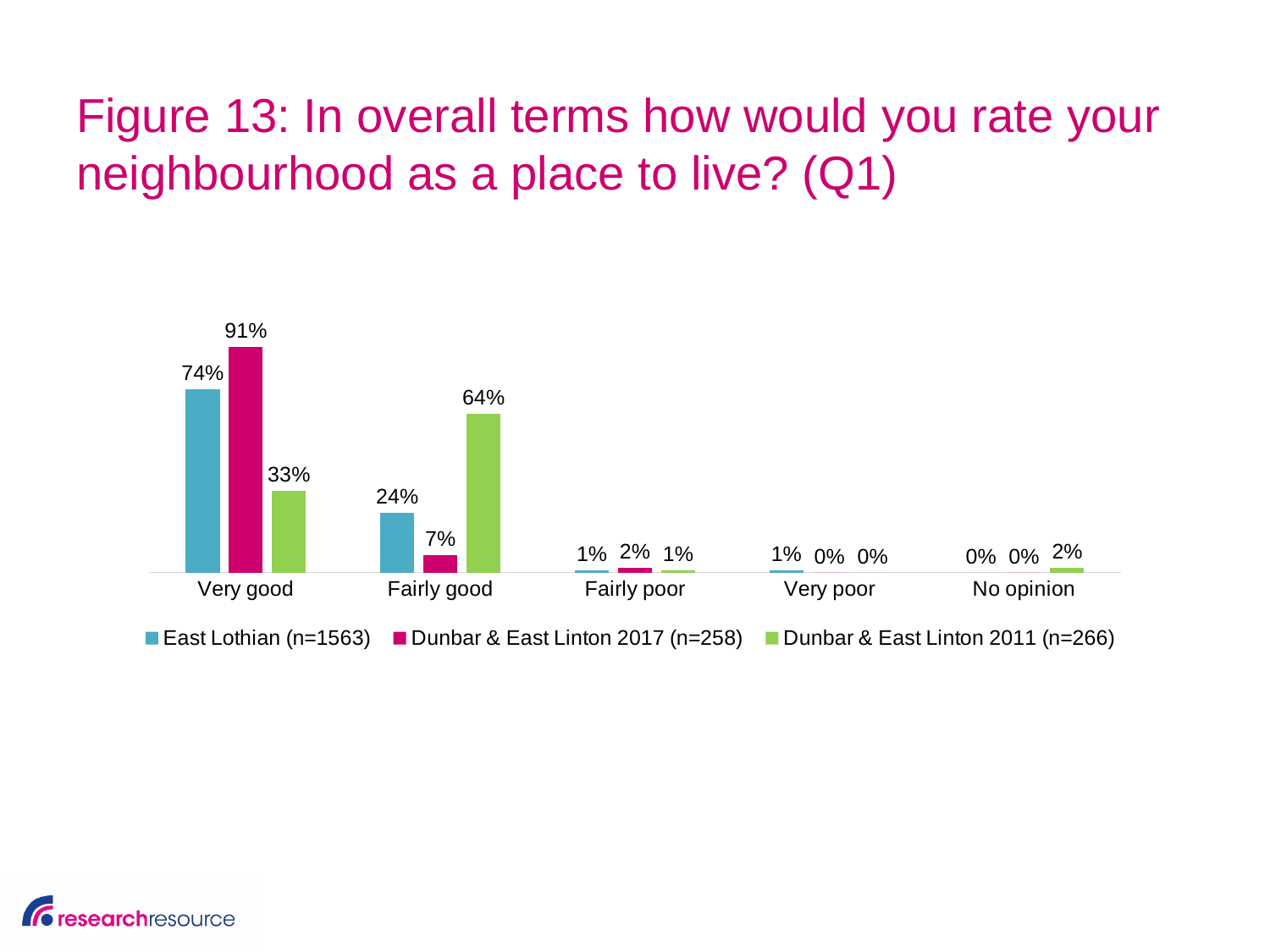
What is the sample size (n) for the Dunbar & East Linton 2017 series shown in the legend? 258 What percentage of Dunbar & East Linton 2017 respondents rated their neighbourhood as Very good? 91% What is the difference between the Dunbar & East Linton 2017 and Dunbar & East Linton 2011 values for Very good? 58% What kind of chart is shown on the slide? Bar chart Which rating category has the highest value for the Dunbar & East Linton 2011 series? Fairly good What percentage of Dunbar & East Linton 2011 respondents rated their neighbourhood as Fairly good? 64% How many rating categories are shown on the x axis? 5 What percentage of Dunbar & East Linton 2017 respondents rated their neighbourhood as Fairly good? 7% What percentage of East Lothian respondents rated their neighbourhood as Very good? 74% How many series does the legend list? 3 What is the difference between the East Lothian and Dunbar & East Linton 2017 values for Fairly good? 17% Which is larger for Very good: the East Lothian value or the Dunbar & East Linton 2011 value? East Lothian